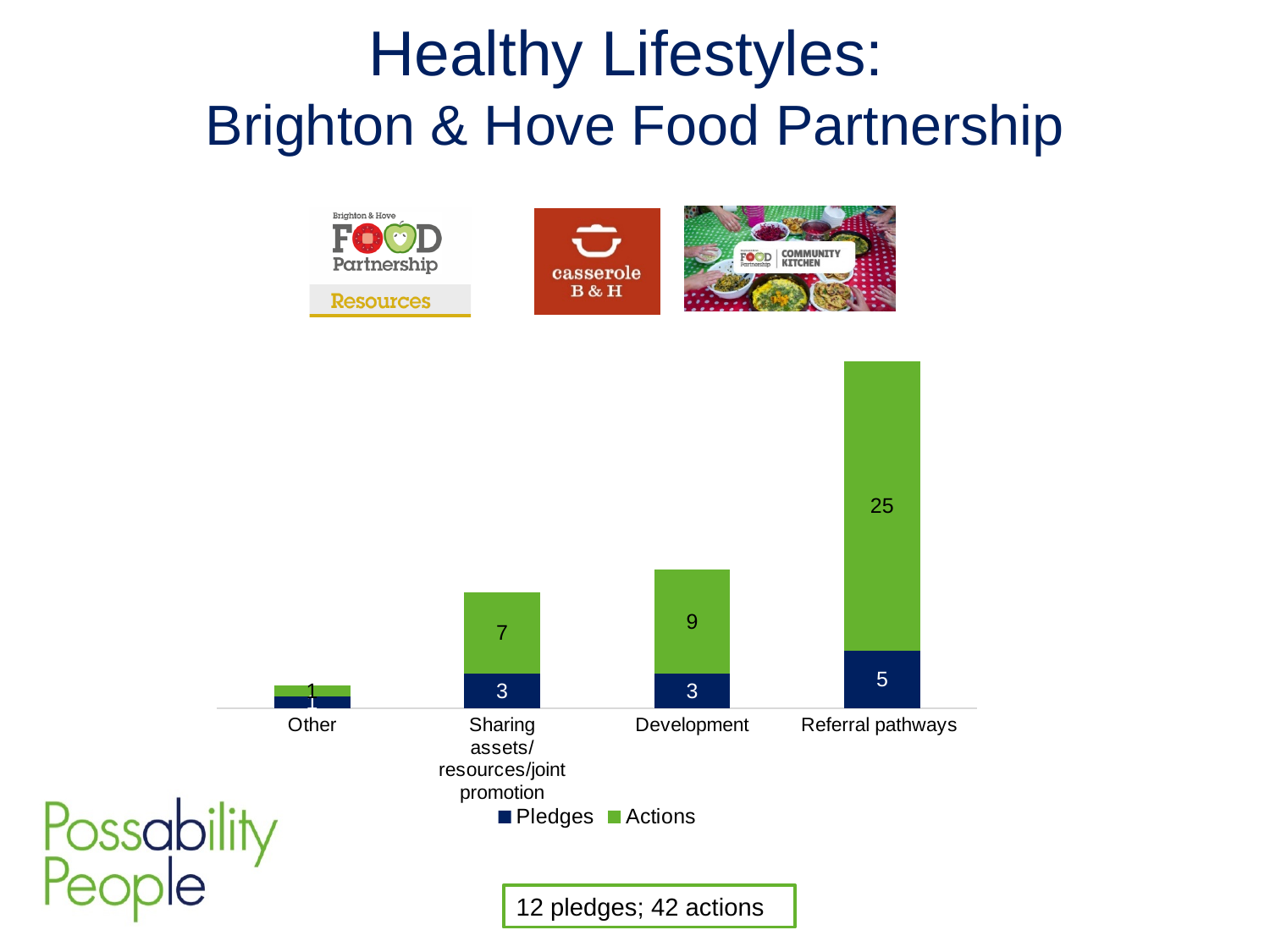
What type of chart is shown on the slide? Stacked bar chart What is the difference between the Actions for Referral pathways and the Actions for Development? 16 What is the total of the stacked bar for Referral pathways (Pledges plus Actions)? 30 Which two series are listed in the chart legend? Pledges and Actions What is the number of Pledges for Development? 3 What is the number of Actions for Sharing assets/resources/joint promotion? 7 Which category has the highest number of Actions? Referral pathways How many categories are shown on the x axis of the chart? 4 How many series does the chart legend list? 2 Which is larger: the Actions for Development or the Actions for Sharing assets/resources/joint promotion? Development What is the number of Actions for Referral pathways? 25 What is the number of Pledges for Referral pathways? 5